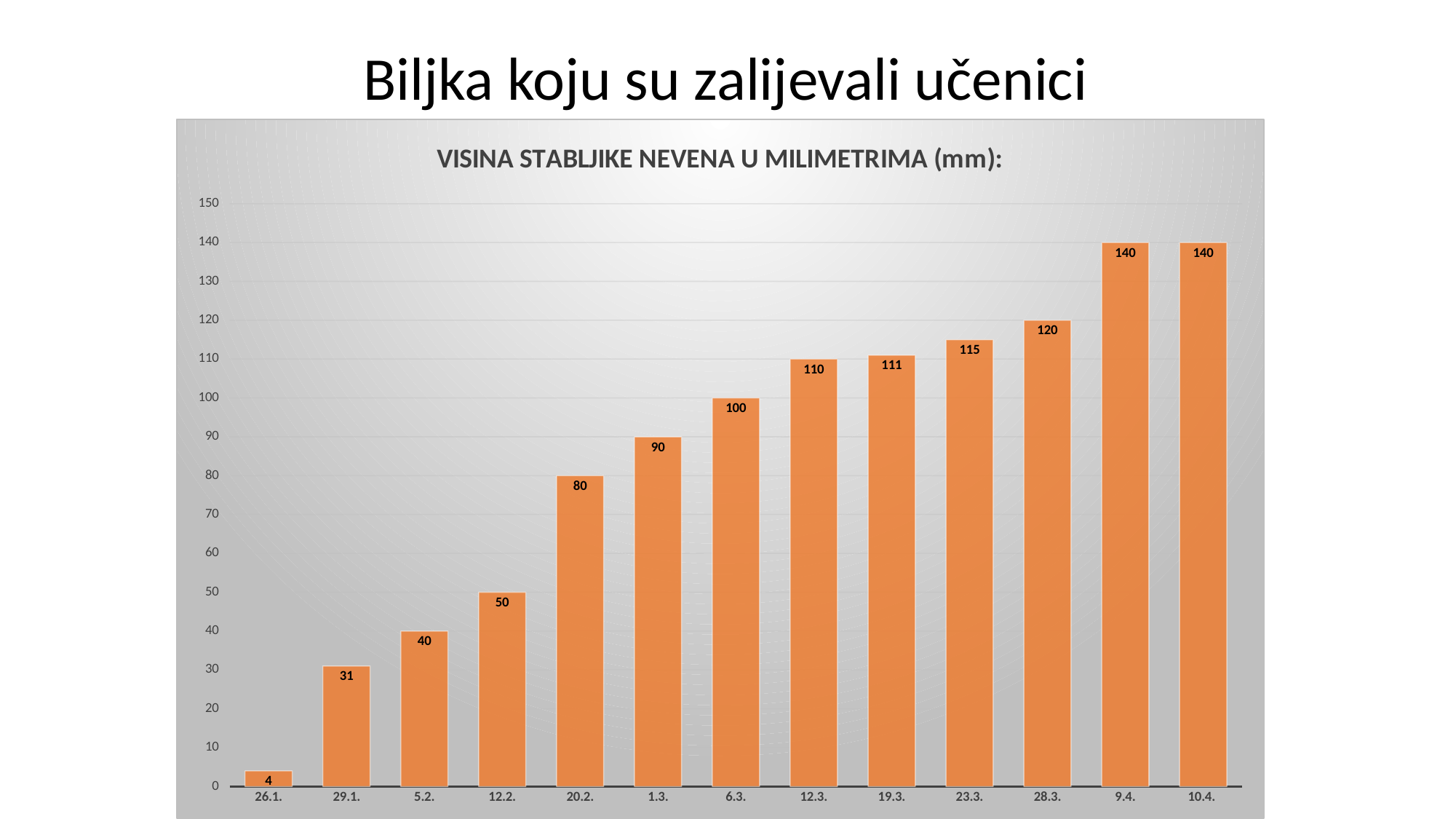
What is the difference between the values for 28.3. and 23.3.? 5 What is the value for 19.3.? 111 What is the value for 26.1.? 4 Is the value for 6.3. greater or less than 90? greater Which date has the lowest value? 26.1. Which is larger, the value for 12.2. or the value for 29.1.? 12.2. Do the values rise or fall from 26.1. to 10.4.? rise How many dates are shown on the x axis? 13 What is the value for 20.2.? 80 What is the title of the chart? VISINA STABLJIKE NEVENA U MILIMETRIMA (mm): What kind of chart is shown on the slide? bar chart What is the difference between the values for 9.4. and 1.3.? 50